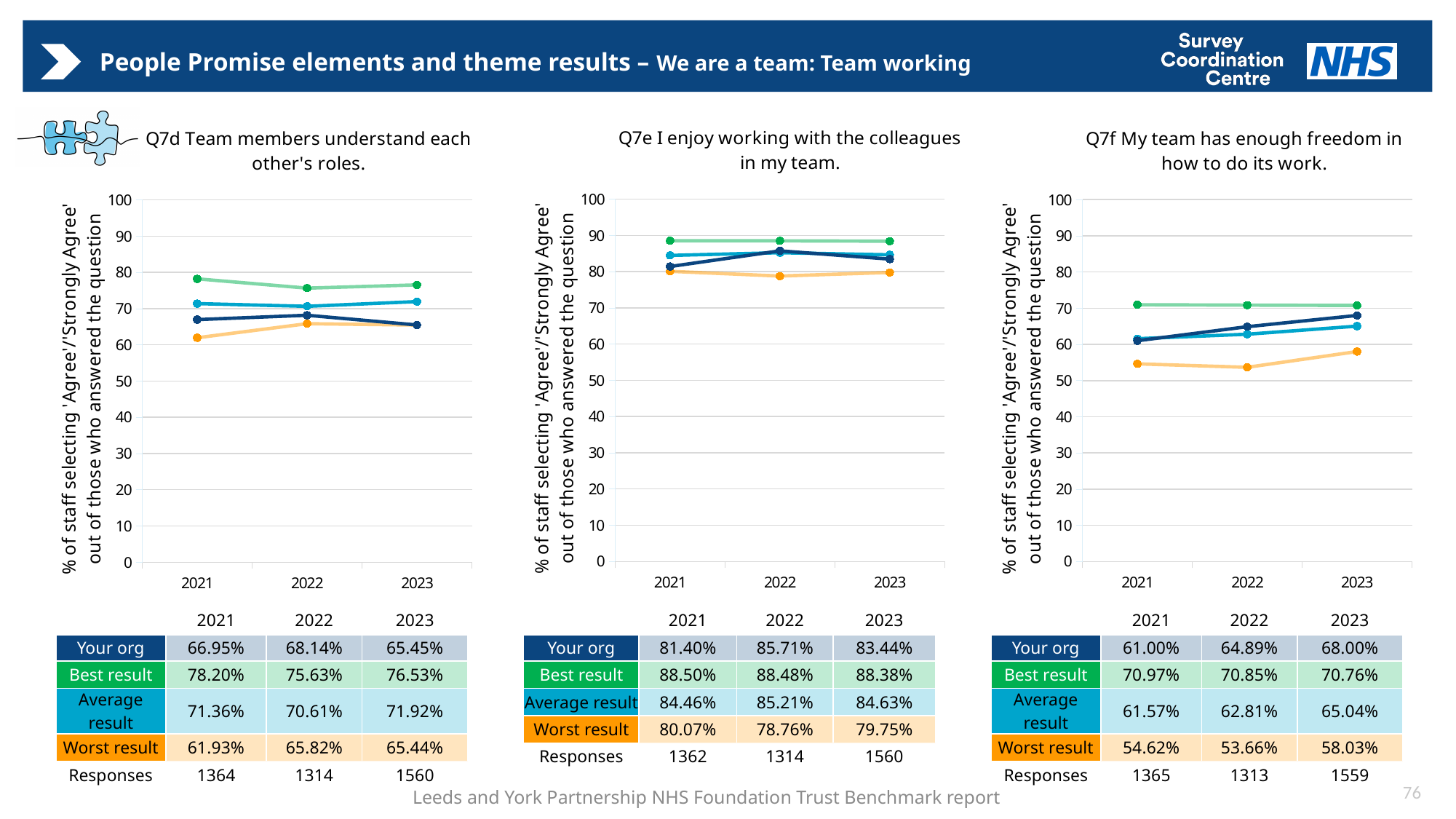
How many years are shown on the x axis of the Q7d Team members understand each other's roles chart? 3 In the Q7f My team has enough freedom in how to do its work chart, in which year was the Worst result value lowest? 2022 In the Q7d Team members understand each other's roles chart, what is the Your org value for 2022? 68.14% In the Q7d Team members understand each other's roles chart, which is larger in 2022: Your org or Average result? Average result In the Q7e I enjoy working with the colleagues in my team chart, is the Best result value for 2022 greater or less than 80? greater How many series are plotted in the Q7f My team has enough freedom in how to do its work chart? 4 What kind of chart is used for the Q7e I enjoy working with the colleagues in my team chart? Line chart In the Q7e I enjoy working with the colleagues in my team chart, what is the Best result value for 2021? 88.50% In the Q7f My team has enough freedom in how to do its work chart, does the Your org value rise or fall from 2021 to 2023? Rise In the Q7f My team has enough freedom in how to do its work chart, what is the Worst result value for 2023? 58.03% In the Q7e I enjoy working with the colleagues in my team chart, by how many percentage points did the Your org value change from 2021 to 2022? 4.31 percentage points In the Q7d Team members understand each other's roles chart, in which year was the Your org value highest? 2022